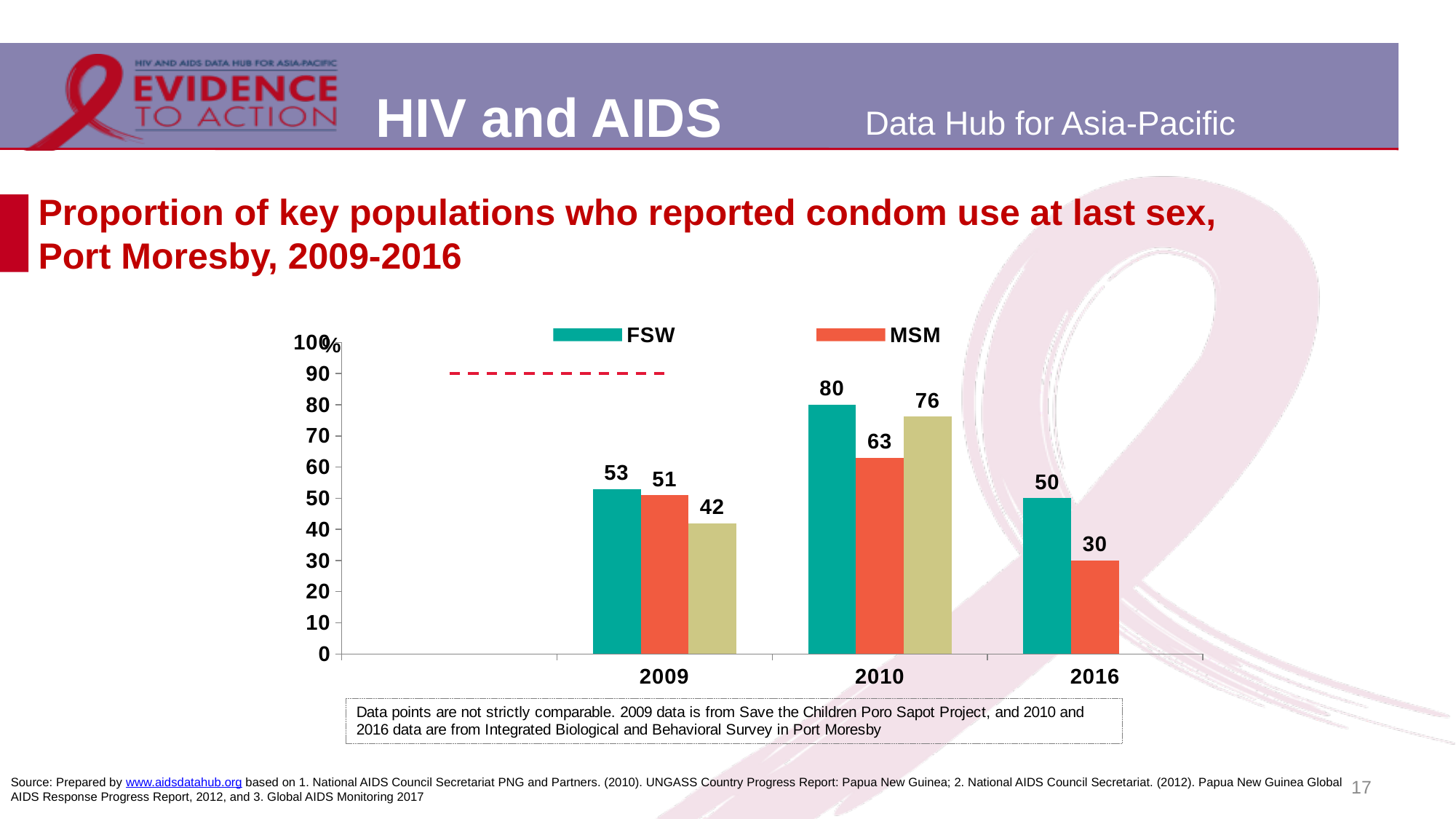
In which year is the FSW value highest? 2010 In which year is the MSM value lowest? 2016 What is the value for MSM in 2016? 30 What is the difference between the FSW and MSM values in 2016? 20 What is the value for MSM in 2010? 63 What is the value for FSW in 2009? 53 How many series does the legend list? 2 What is the value for FSW in 2010? 80 Which is larger in 2010, the FSW value or the MSM value? FSW By how much did the FSW value change from 2010 to 2016? 30 How many years are shown on the x axis? 3 What kind of chart is shown on the slide? bar chart